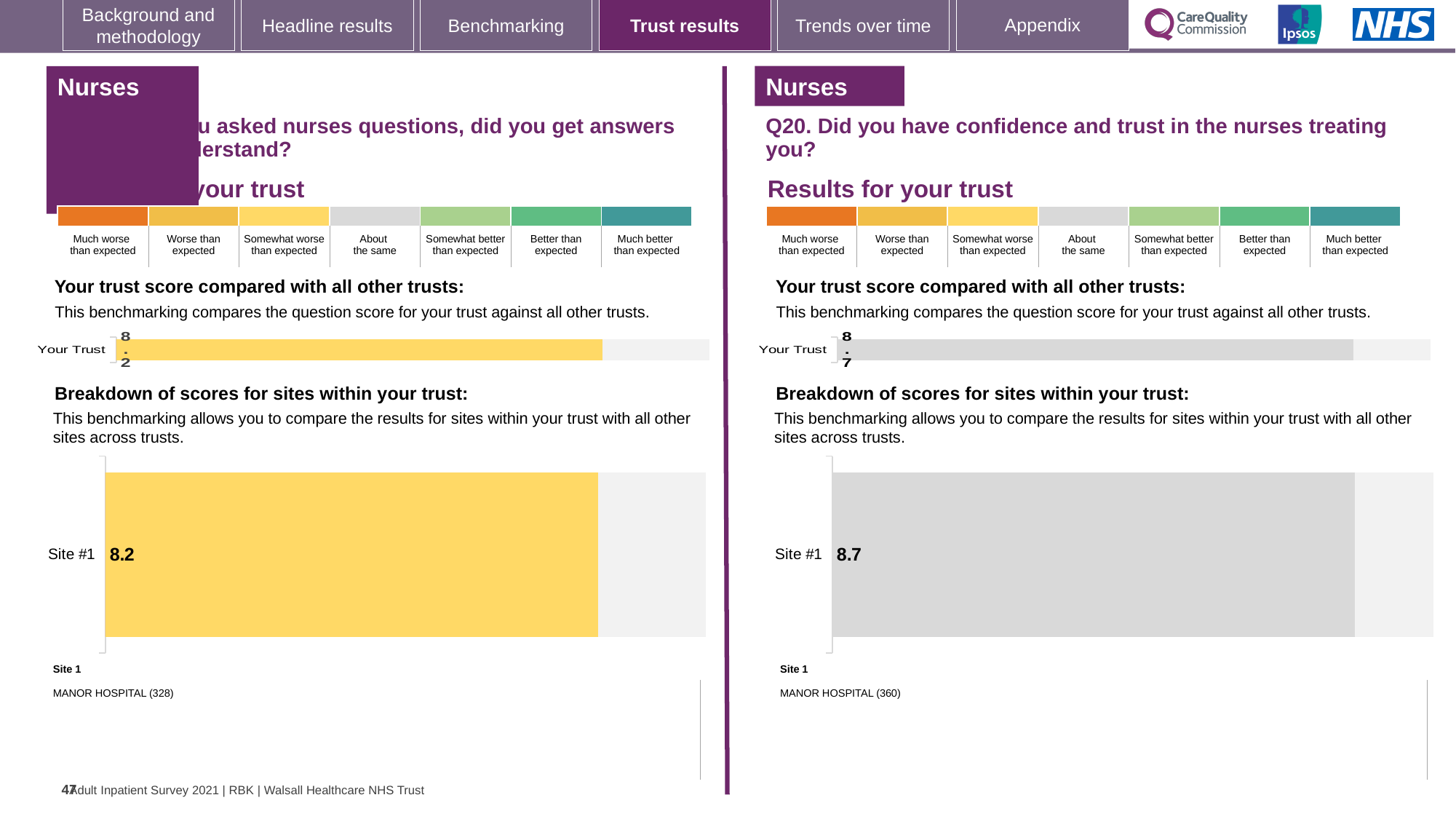
What is the difference between the Site #1 score on the right-hand (Q20) chart and the Site #1 score on the left-hand chart? 0.5 In the site breakdown chart on the left-hand side, what is the score for Site #1? 8.2 In the site breakdown chart on the right-hand side (Q20), what is the score for Site #1? 8.7 On the right-hand side of the slide (Q20, confidence and trust in nurses), what is the score shown for Your Trust? 8.7 How many sites are shown in the site breakdown chart on the right-hand side (Q20)? 1 What type of chart is used to show the Your Trust score on the left-hand side? Bar chart How many sites are shown in the site breakdown chart on the left-hand side? 1 What type of chart is used to show the Site #1 score on the right-hand side (Q20)? Bar chart Which is larger: the Site #1 score in the left-hand breakdown chart or the Site #1 score in the right-hand (Q20) breakdown chart? The right-hand (Q20) chart Which site name is listed as Site 1 below the right-hand (Q20) breakdown chart? MANOR HOSPITAL (360) On the left-hand side of the slide, what is the score shown for Your Trust? 8.2 Which site name is listed as Site 1 below the left-hand breakdown chart? MANOR HOSPITAL (328)